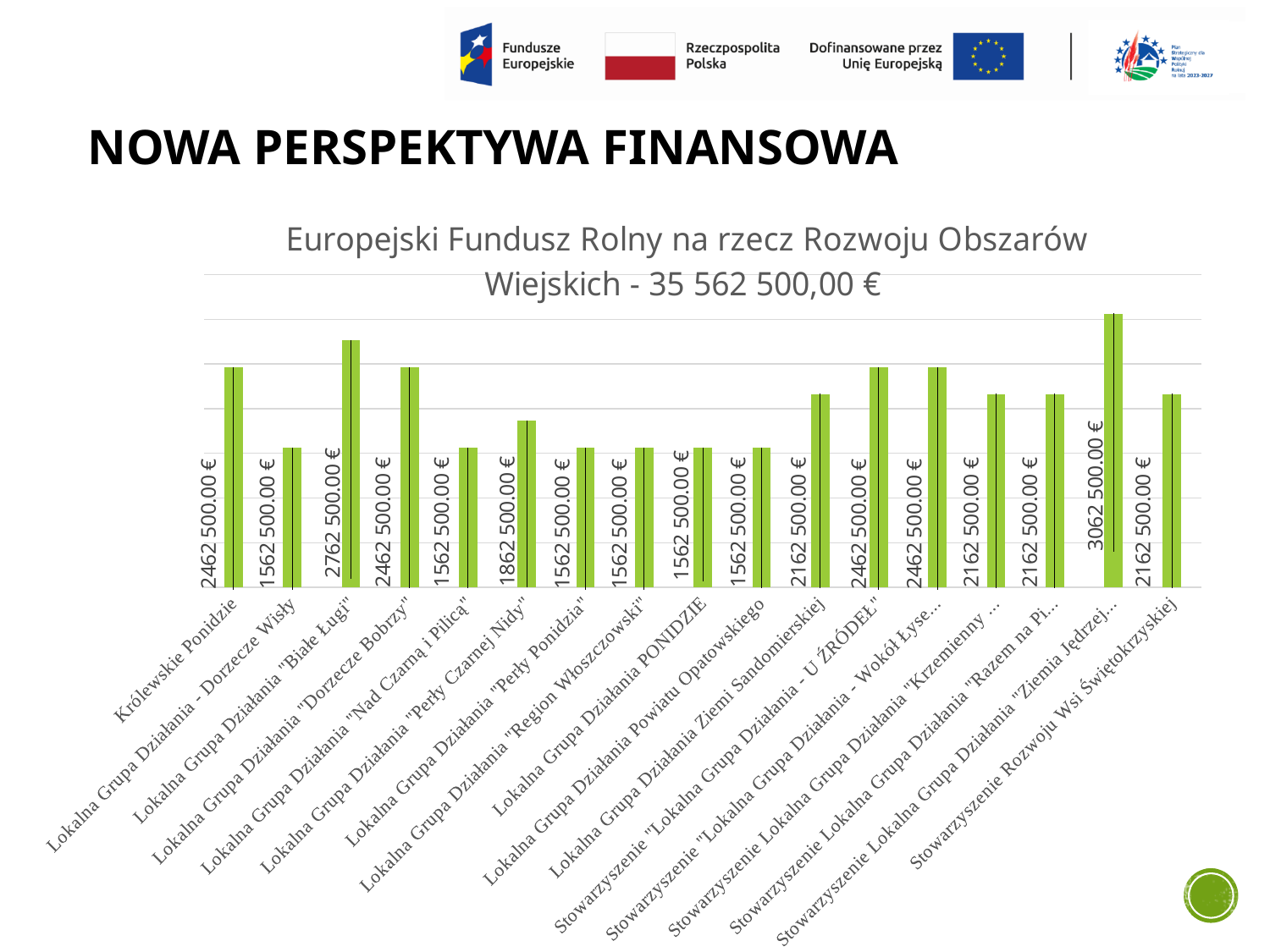
What is the difference between the values for Lokalna Grupa Działania "Białe Ługi" and Lokalna Grupa Działania - Dorzecze Wisły? 1 200 000,00 € What is the value for Lokalna Grupa Działania "Białe Ługi"? 2762 500,00 € What total amount is stated in the chart title? 35 562 500,00 € What is the value for Stowarzyszenie Rozwoju Wsi Świętokrzyskiej? 2162 500,00 € Which is larger, the value for Lokalna Grupa Działania "Dorzecze Bobrzy" or the value for Lokalna Grupa Działania "Perły Ponidzia"? Lokalna Grupa Działania "Dorzecze Bobrzy" What is the value for Lokalna Grupa Działania "Perły Czarnej Nidy"? 1862 500,00 € What is the value for Lokalna Grupa Działania Ziemi Sandomierskiej? 2162 500,00 € What is the lowest value shown on the chart? 1562 500,00 € Which category has the highest value? Stowarzyszenie Lokalna Grupa Działania "Ziemia Jędrzej..." What is the value for Królewskie Ponidzie? 2462 500,00 € How many categories are shown on the chart? 17 What kind of chart is shown on the slide? Bar chart